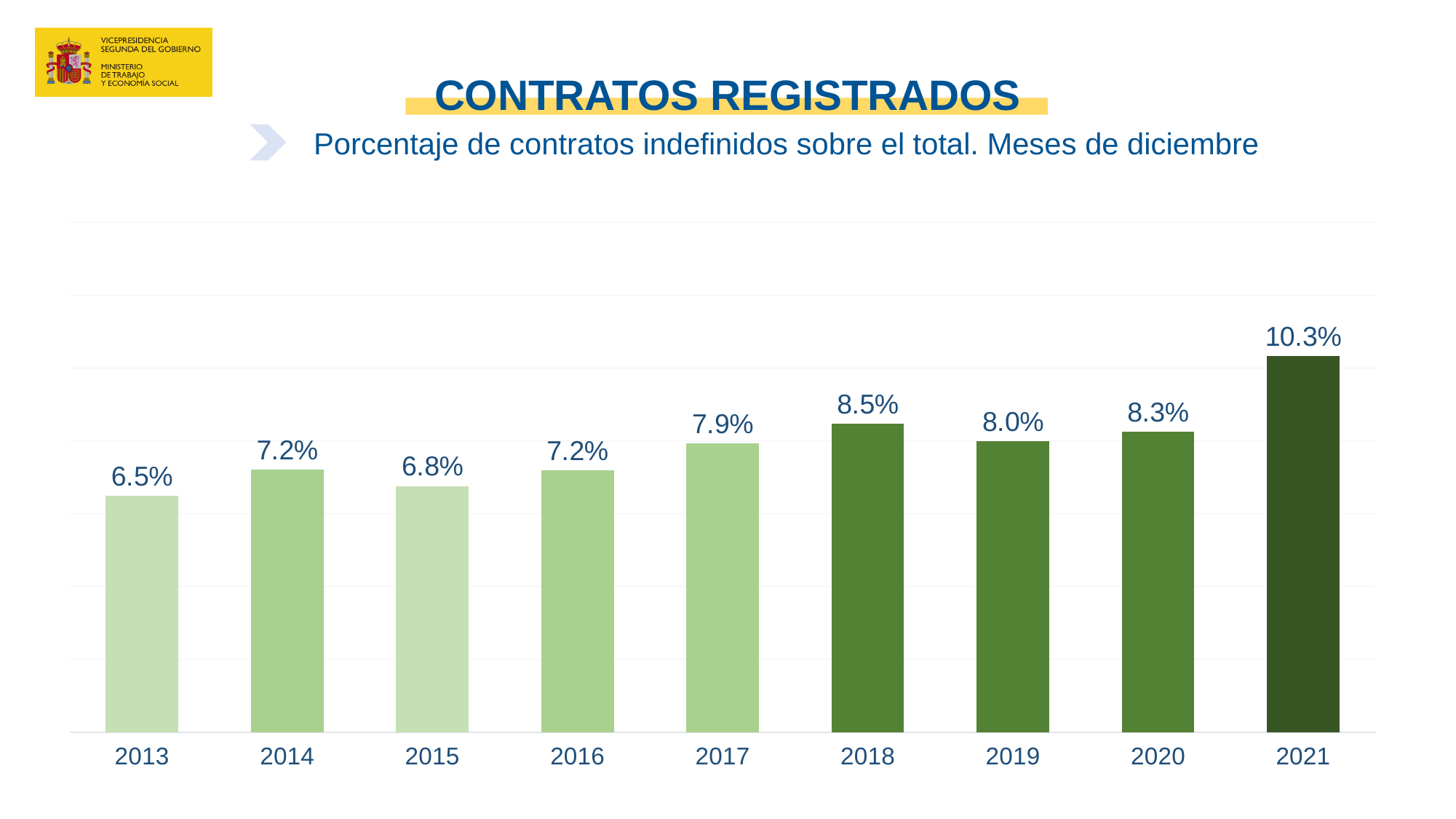
How many years are shown on the x axis? 9 Which is larger, the value for 2017 or the value for 2019? 2019 Which year has the lowest value? 2013 What is the value for 2021? 10.3% What is the subtitle of the chart? Porcentaje de contratos indefinidos sobre el total. Meses de diciembre Which year has the highest value? 2021 What is the value for 2018? 8.5% What is the value for 2013? 6.5% What is the difference between the values for 2021 and 2020? 2.0% What is the difference between the values for 2018 and 2019? 0.5% What kind of chart is this? bar chart Do the values generally rise or fall from 2013 to 2021? rise